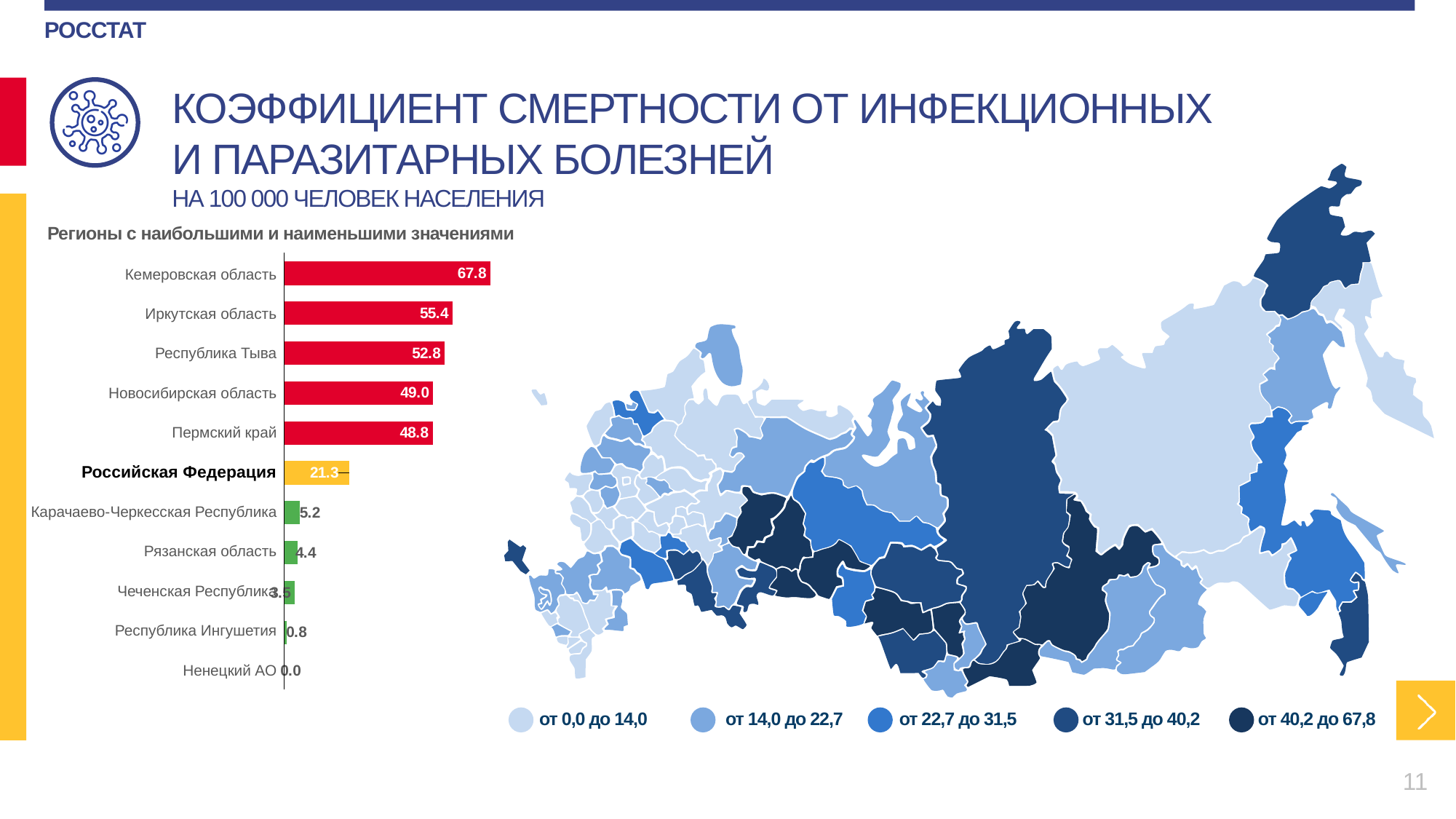
What is the difference between the values for Кемеровская область and Иркутская область? 12.4 What kind of chart is used to show the regions with the highest and lowest values? Bar chart What range does the darkest colour on the map legend represent? от 40,2 до 67,8 How many value ranges does the map legend list? 5 Which region has the highest value in the bar chart? Кемеровская область Which region has the lowest value in the bar chart? Ненецкий АО What is the value for Республика Ингушетия in the bar chart? 0.8 How many regions (bars) are shown in the bar chart? 11 What is the value for Российская Федерация in the bar chart? 21.3 Which is larger, the value for Республика Тыва or the value for Пермский край? Республика Тыва What is the difference between the values for Новосибирская область and Российская Федерация? 27.7 What is the value for Кемеровская область in the bar chart? 67.8